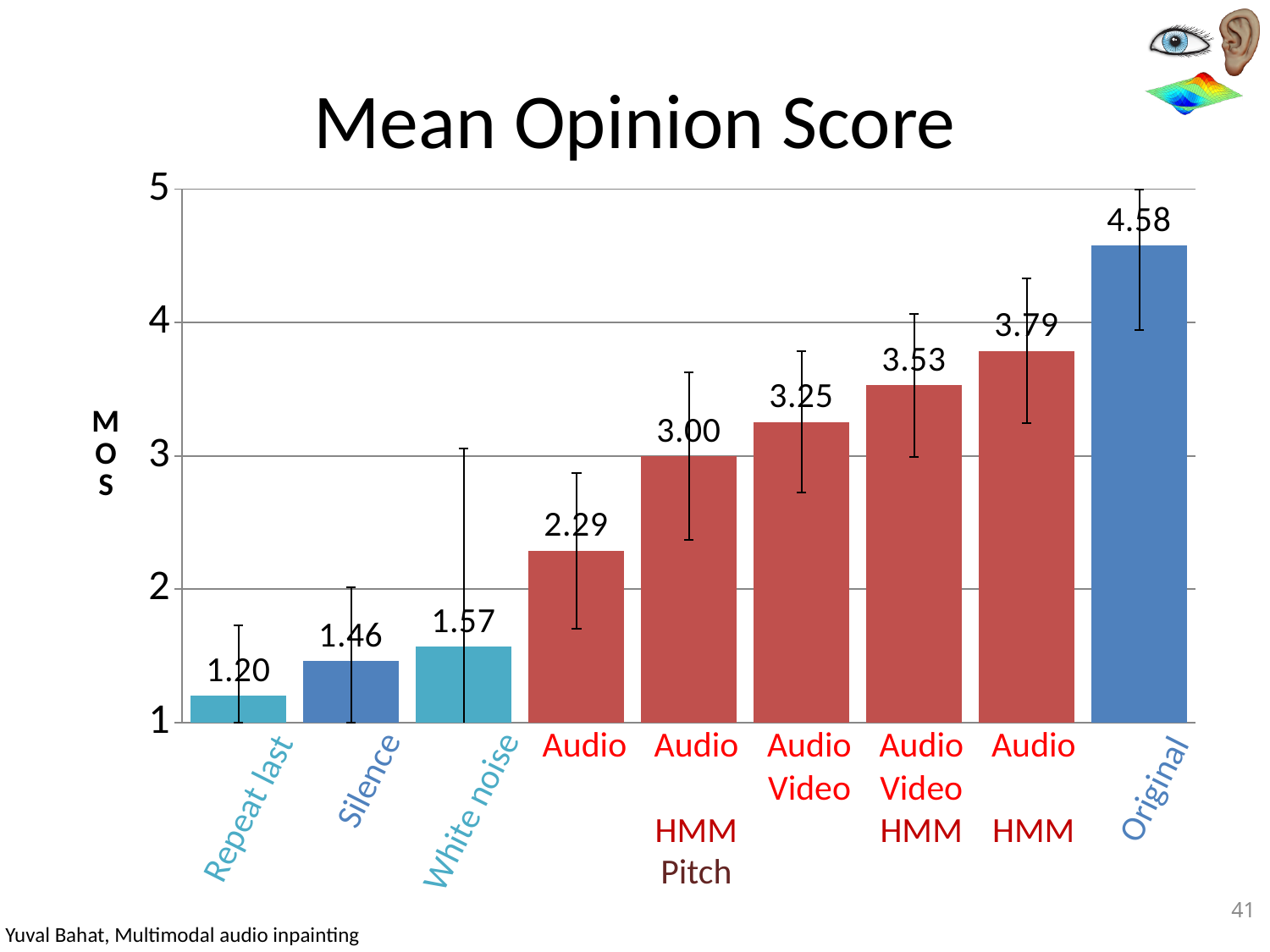
How many bars are shown in the chart? 9 What is the difference between the Mean Opinion Score for Audio Video and for Audio? 0.96 What is the Mean Opinion Score for Silence? 1.46 What is the Mean Opinion Score for the Audio Video HMM method? 3.53 What type of chart is shown on the slide? bar chart Which category has the lowest Mean Opinion Score? Repeat last Is the Mean Opinion Score for Audio HMM greater or less than 4? less What is the Mean Opinion Score for Original? 4.58 Which has a higher Mean Opinion Score, Audio HMM Pitch or Audio Video HMM? Audio Video HMM Which category has the highest Mean Opinion Score? Original What is the difference between the Mean Opinion Score for Original and for Audio HMM? 0.79 What is the Mean Opinion Score for White noise? 1.57